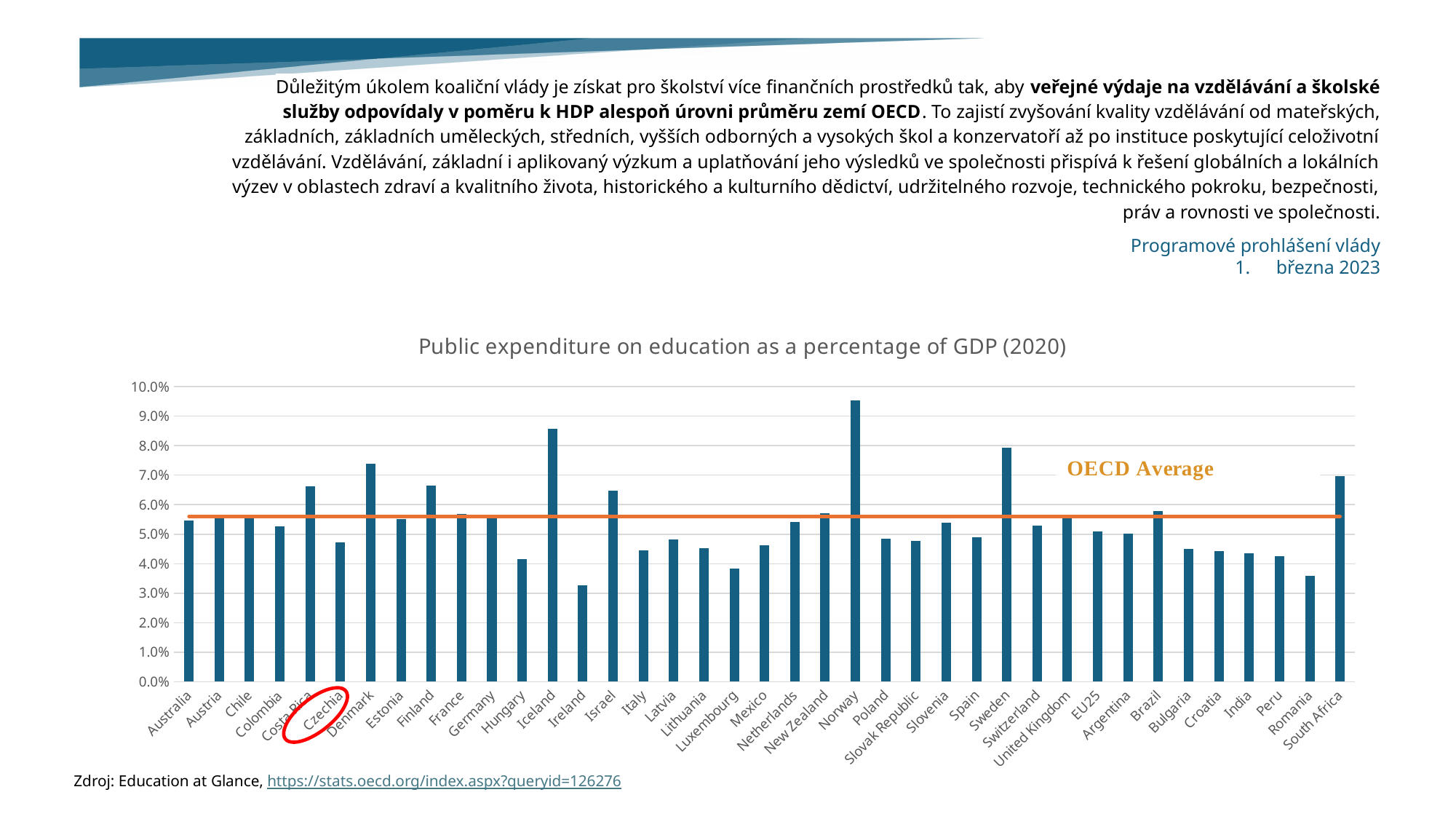
Is the value for Norway greater or less than 9.0%? greater What is the title of the chart? Public expenditure on education as a percentage of GDP (2020) What does the orange horizontal line across the chart represent? OECD Average Is the value for Iceland greater or less than 8.0%? greater What kind of chart is shown on the slide? bar chart Which has a higher value, Iceland or Sweden? Iceland Is the value for Sweden greater or less than 7.0%? greater Which country has the highest public expenditure on education as a percentage of GDP in the chart? Norway Which has a higher value, Denmark or Czechia? Denmark Which country has the lowest public expenditure on education as a percentage of GDP in the chart? Ireland